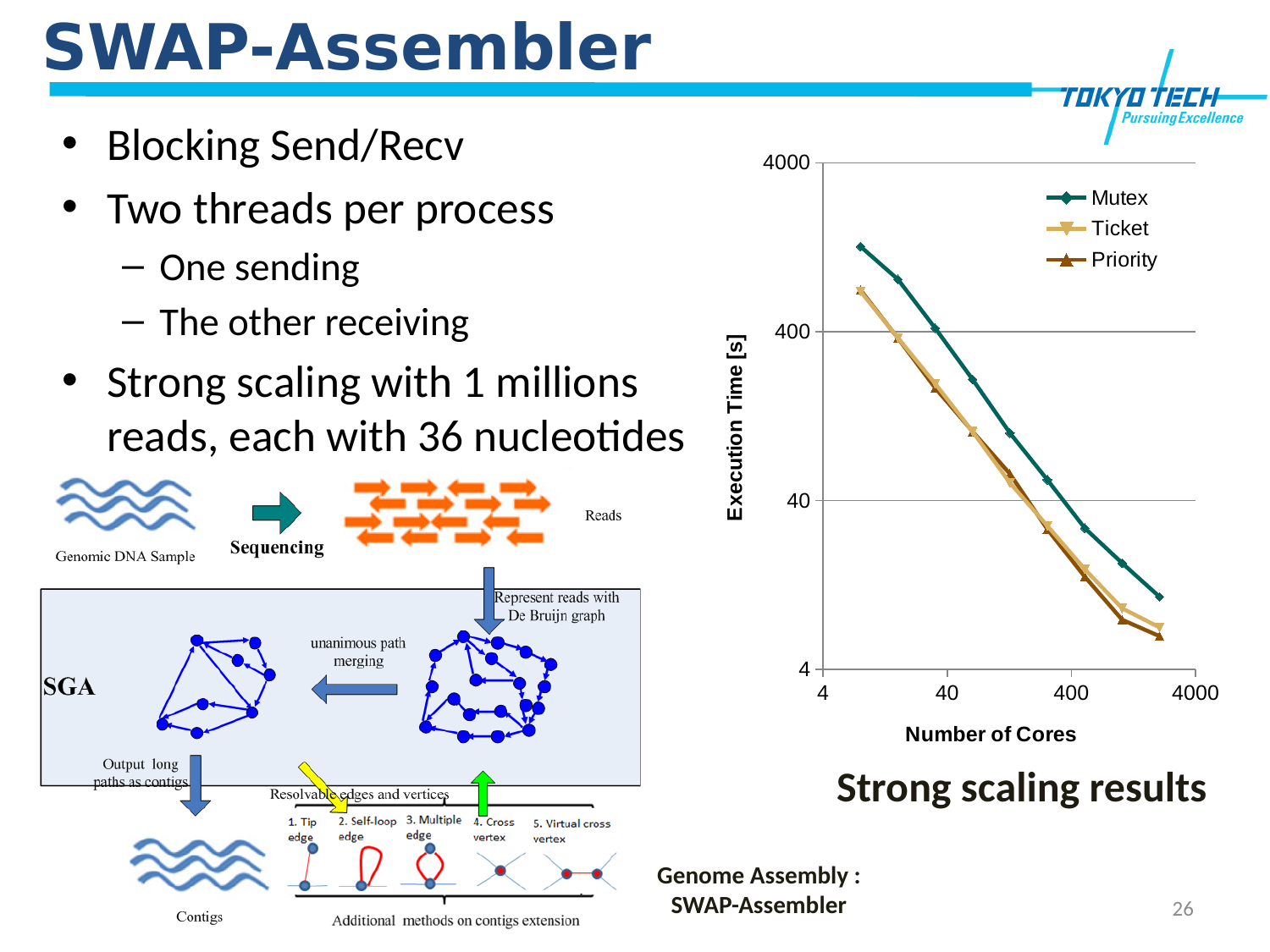
Which series has the highest execution time at the largest number of cores plotted? Mutex At the largest number of cores plotted, which has the higher execution time, Mutex or Ticket? Mutex At the largest number of cores plotted, is the execution time for Priority greater or less than 40? less How many series does the chart legend list? 3 At the smallest number of cores plotted, is the execution time for Ticket greater or less than 400? greater At the largest number of cores plotted, is the execution time for Mutex greater or less than 40? less As the number of cores increases, does the execution time rise or fall? fall Which series has the highest execution time at the smallest number of cores plotted? Mutex What kind of chart is shown on the slide? line chart Which series are listed in the chart legend? Mutex, Ticket, Priority What is the label of the chart's x axis? Number of Cores